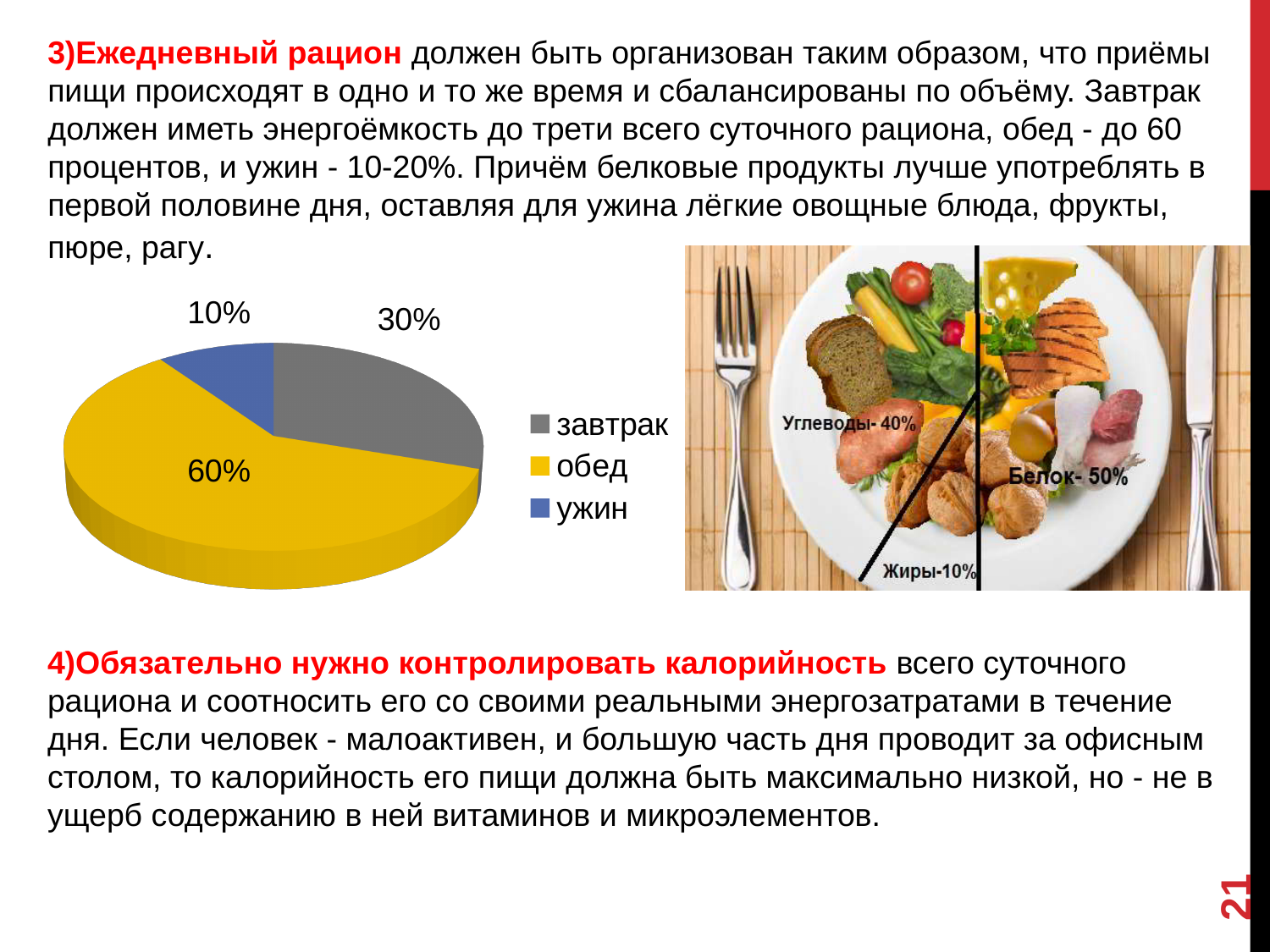
What share of the pie chart does ужин (dinner) take? 10% Which slice is larger in the pie chart, завтрак or ужин? завтрак What is the difference in percentage points between обед and завтрак in the pie chart? 30 What share of the pie chart does обед (lunch) take? 60% What type of chart is shown on the slide? pie chart Which meal has the largest slice in the pie chart? обед What is the difference in percentage points between завтрак and ужин in the pie chart? 20 How many entries does the pie chart legend list? 3 Which meal has the smallest slice in the pie chart? ужин What share of the pie chart does завтрак (breakfast) take? 30% How many slices does the pie chart have? 3 What colour is the обед slice in the pie chart? yellow